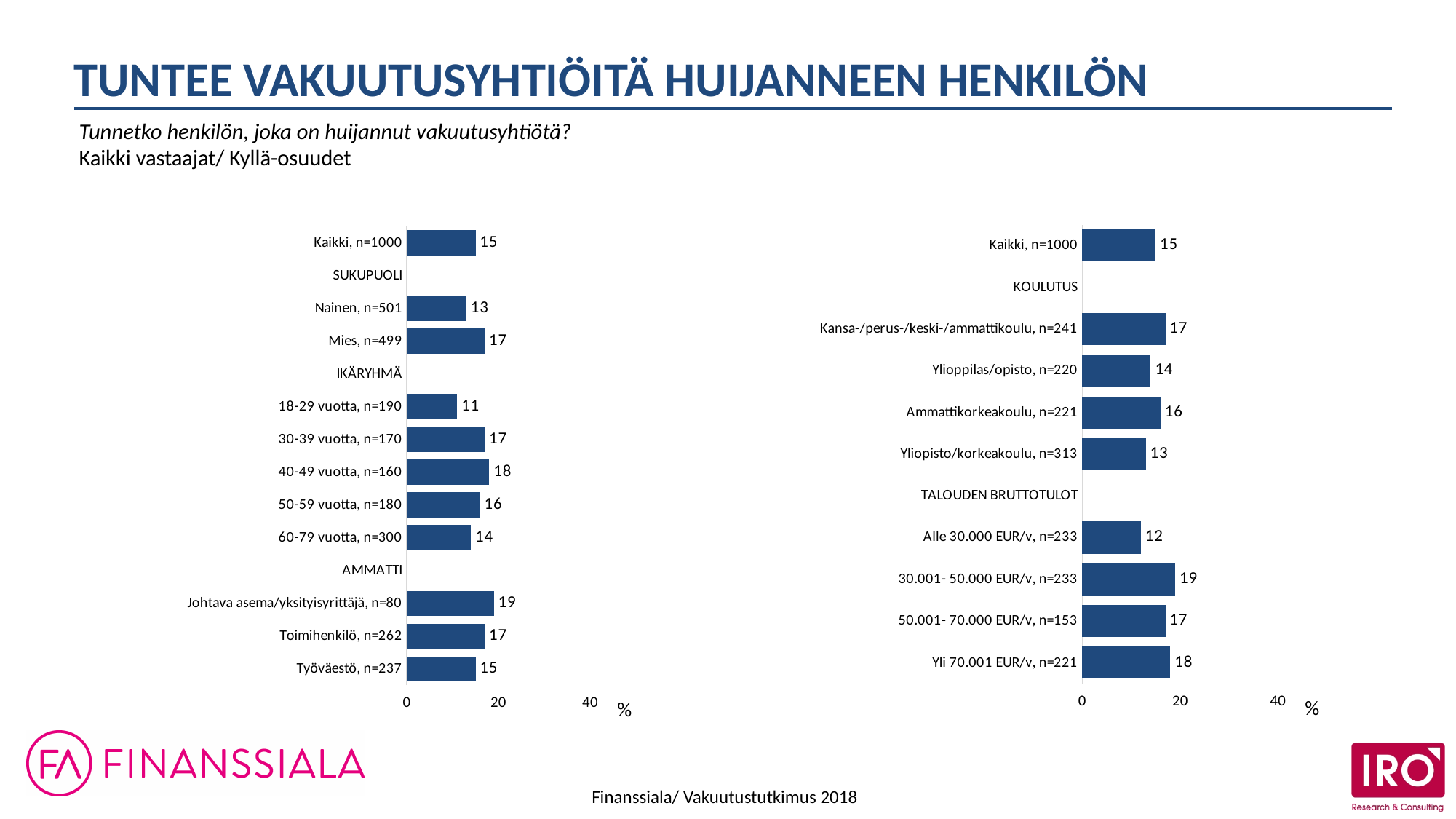
In the right chart, which category has the lowest value? Alle 30.000 EUR/v, n=233 In the left chart, what is the value for 18-29 vuotta, n=190? 11 In the left chart, what is the value for Nainen, n=501? 13 In the left chart, which is larger: the value for 40-49 vuotta, n=160 or 60-79 vuotta, n=300? 40-49 vuotta, n=160 In the left chart, which category has the highest value? Johtava asema/yksityisyrittäjä, n=80 In the right chart, what is the value for 30.001- 50.000 EUR/v, n=233? 19 In the right chart, what is the value for Yliopisto/korkeakoulu, n=313? 13 In the right chart, what is the difference between the values for Yli 70.001 EUR/v, n=221 and Alle 30.000 EUR/v, n=233? 6 In the right chart, is the value for Kansa-/perus-/keski-/ammattikoulu, n=241 greater or less than 20? less In the left chart, what is the difference between the values for Mies, n=499 and Nainen, n=501? 4 In the left chart, which category has the lowest value? 18-29 vuotta, n=190 What type of chart is shown on the left of the slide? Bar chart